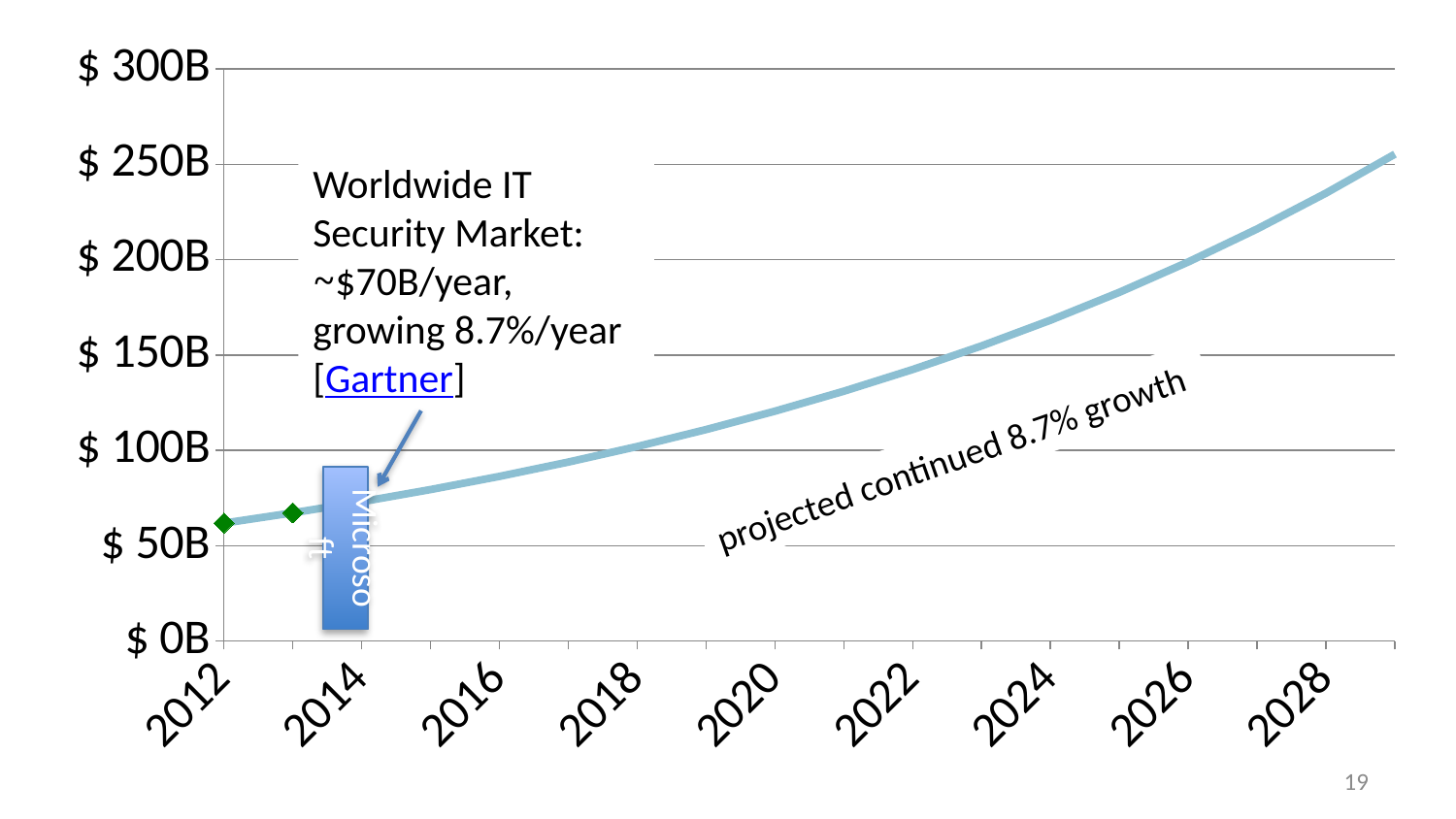
What is the highest value labelled on the y axis? $ 300B Is the value for 2016 greater or less than $100B? less Is the value for 2012 greater or less than $100B? less How many year labels are shown on the x axis? 9 Is the value for 2024 greater or less than $150B? greater Does the plotted line rise or fall from 2012 to 2028? rises What annual growth rate does the text on the chart say is projected to continue? 8.7% What kind of chart is shown on the slide? line chart